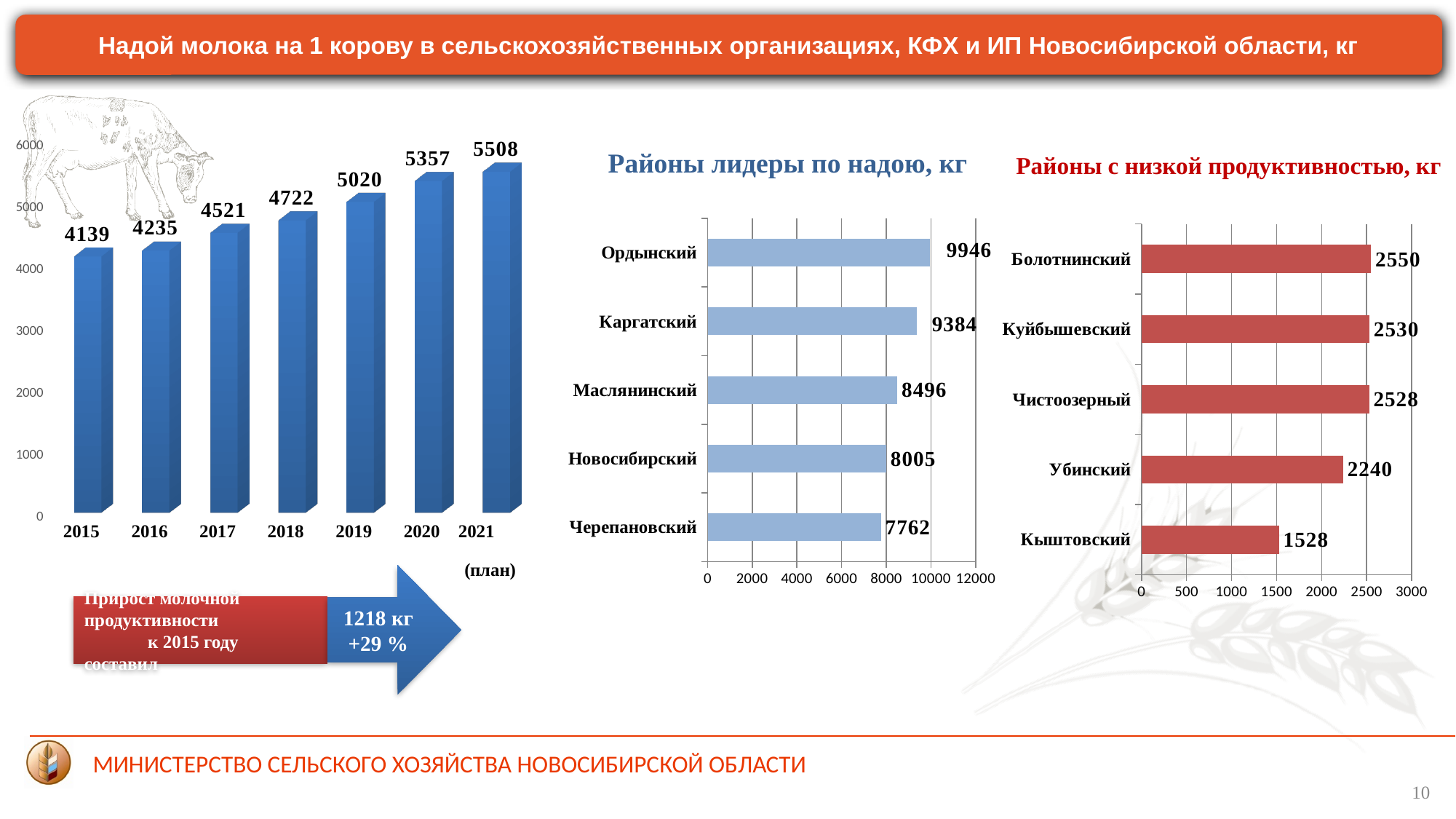
In the chart 'Районы лидеры по надою, кг', what is the difference between Ордынский and Черепановский? 2184 In the left chart of milk yield per cow by year, how many years are shown? 7 In the left chart of milk yield per cow by year, what is the value for 2019? 5020 In the chart 'Районы с низкой продуктивностью, кг', what is the value for Убинский? 2240 In the chart 'Районы лидеры по надою, кг', what is the value for Маслянинский? 8496 What type of chart is 'Районы с низкой продуктивностью, кг'? bar chart In the left chart of milk yield per cow by year, what is the difference between the 2020 and 2015 values? 1218 In the left chart of milk yield per cow by year, do the values rise or fall from 2015 to 2021? rise In the left chart of milk yield per cow by year, what is the planned value for 2021? 5508 In the chart 'Районы с низкой продуктивностью, кг', which district has the lowest value? Кыштовский In the chart 'Районы лидеры по надою, кг', which district has the highest value? Ордынский In the chart 'Районы с низкой продуктивностью, кг', which is larger, Болотнинский or Кыштовский? Болотнинский